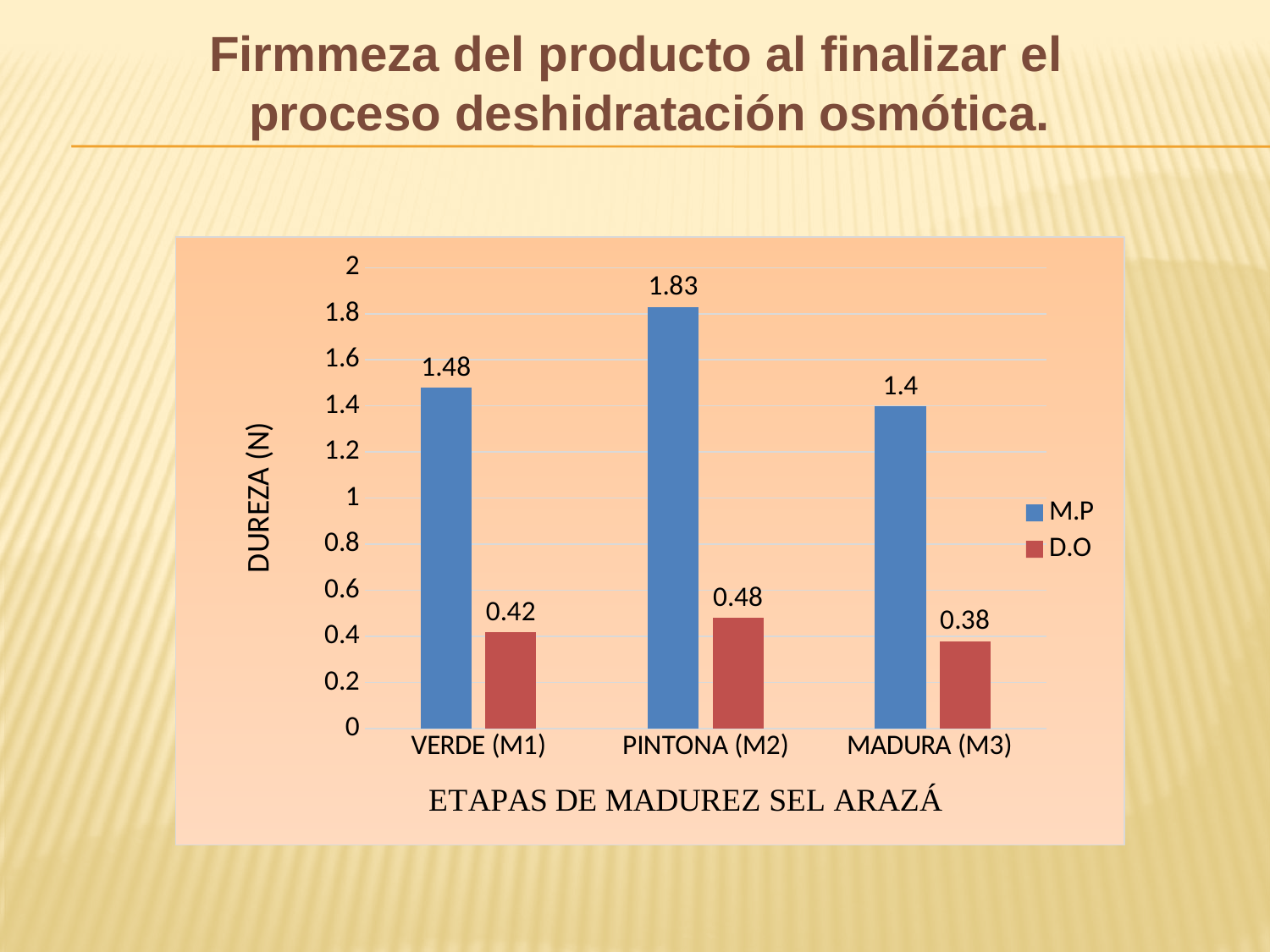
Which category has the lowest D.O value? MADURA (M3) What is the label of the y axis? DUREZA (N) How many categories are shown on the x axis? 3 Which is larger, the D.O value for VERDE (M1) or the D.O value for PINTONA (M2)? PINTONA (M2) What is the M.P value for MADURA (M3)? 1.4 What is the difference between the M.P and D.O values for PINTONA (M2)? 1.35 Which category has the highest M.P value? PINTONA (M2) What is the M.P value for VERDE (M1)? 1.48 What kind of chart is shown on the slide? Bar chart What is the D.O value for MADURA (M3)? 0.38 What is the D.O value for PINTONA (M2)? 0.48 How many series does the legend list? 2